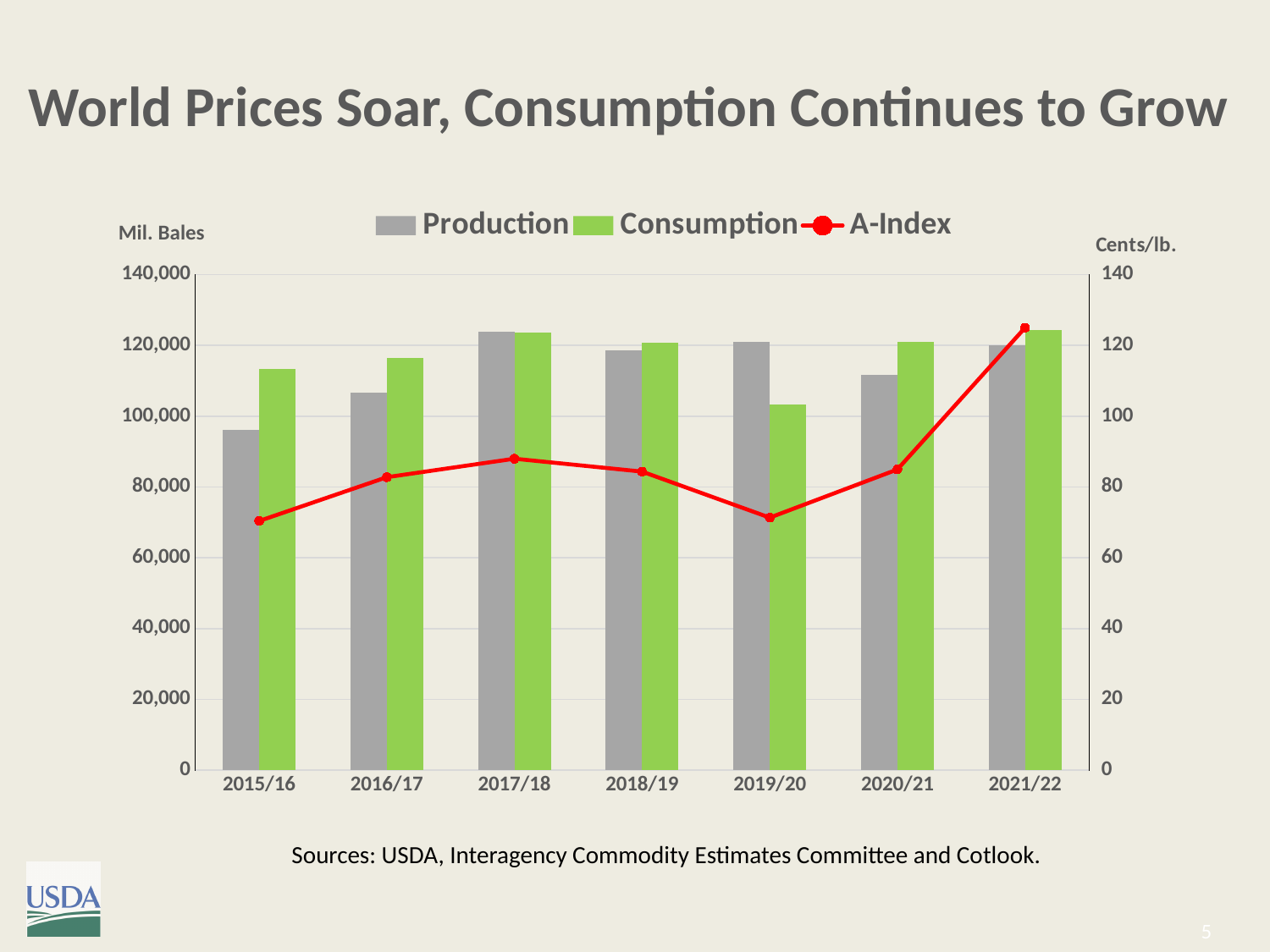
How many marketing years are shown on the x axis? 7 How many series does the legend list? 3 In which year is the A-Index highest? 2021/22 In which year is Production lowest? 2015/16 In 2015/16, which is larger, Production or Consumption? Consumption Is the A-Index value for 2021/22 greater or less than 120? greater Is the Production value for 2015/16 greater or less than 100,000? less In which year is Consumption lowest? 2019/20 Is the A-Index value for 2015/16 greater or less than 80? less In 2019/20, which is larger, Production or Consumption? Production What kind of chart is this? Combined bar and line chart What unit is shown on the right-hand axis? Cents/lb.